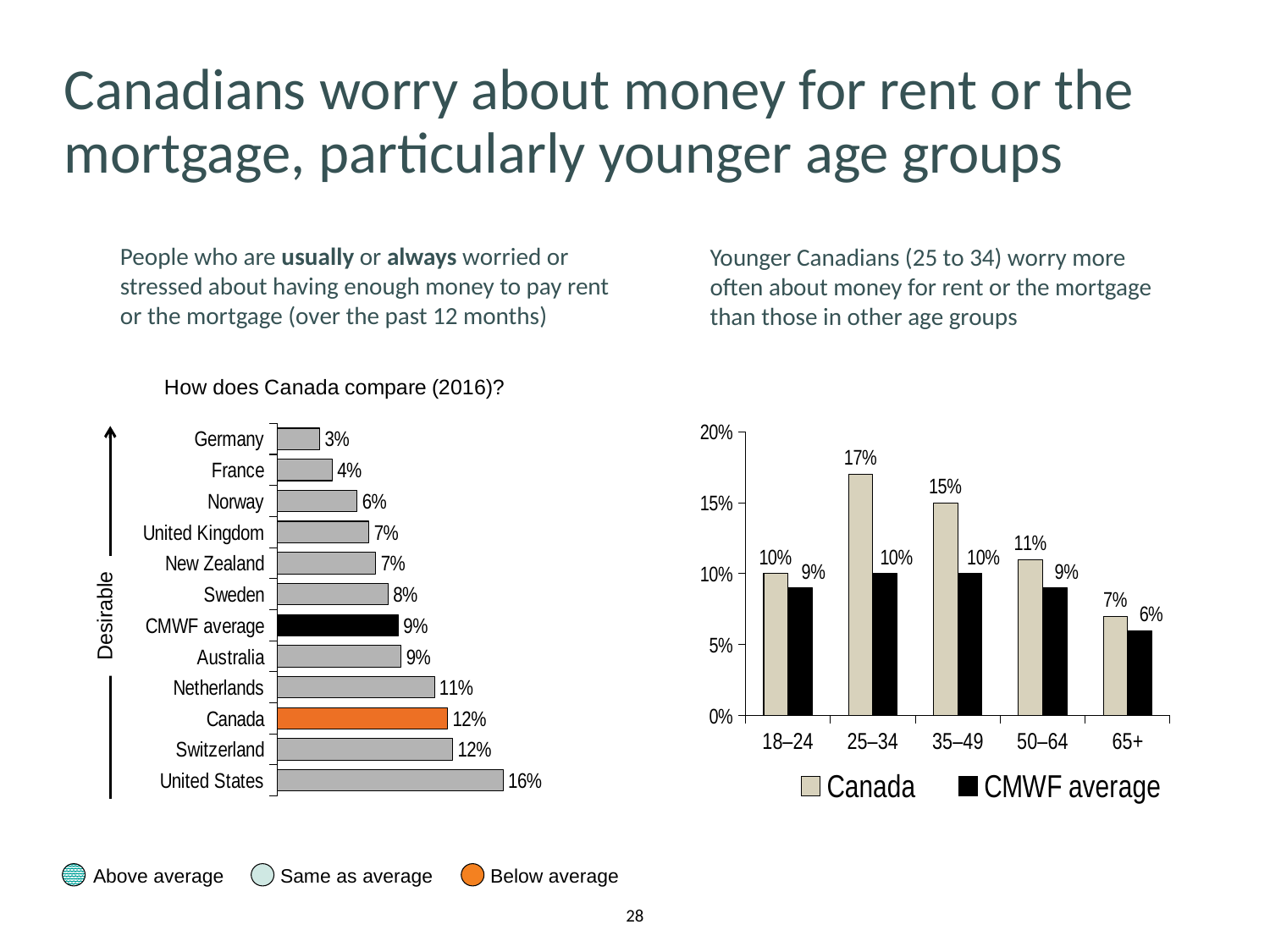
In the left chart 'How does Canada compare (2016)?', what is the value for the CMWF average? 9% In the left chart 'How does Canada compare (2016)?', which country has the lowest value? Germany In the left chart 'How does Canada compare (2016)?', which country has the highest value? United States In the right chart by age group, what is the CMWF average value for the 65+ age group? 6% In the left chart 'How does Canada compare (2016)?', how many bars are shown? 12 In the right chart by age group, what is the difference between Canada and the CMWF average for the 35–49 age group? 5% In the right chart by age group, which age group has the highest Canada value? 25–34 In the right chart by age group, what is the Canada value for the 25–34 age group? 17% In the left chart 'How does Canada compare (2016)?', what is the value for Canada? 12% In the right chart by age group, how many series does the legend list? 2 In the left chart 'How does Canada compare (2016)?', what kind of chart is it? Bar chart In the left chart 'How does Canada compare (2016)?', what is the difference between the United States and Germany? 13%